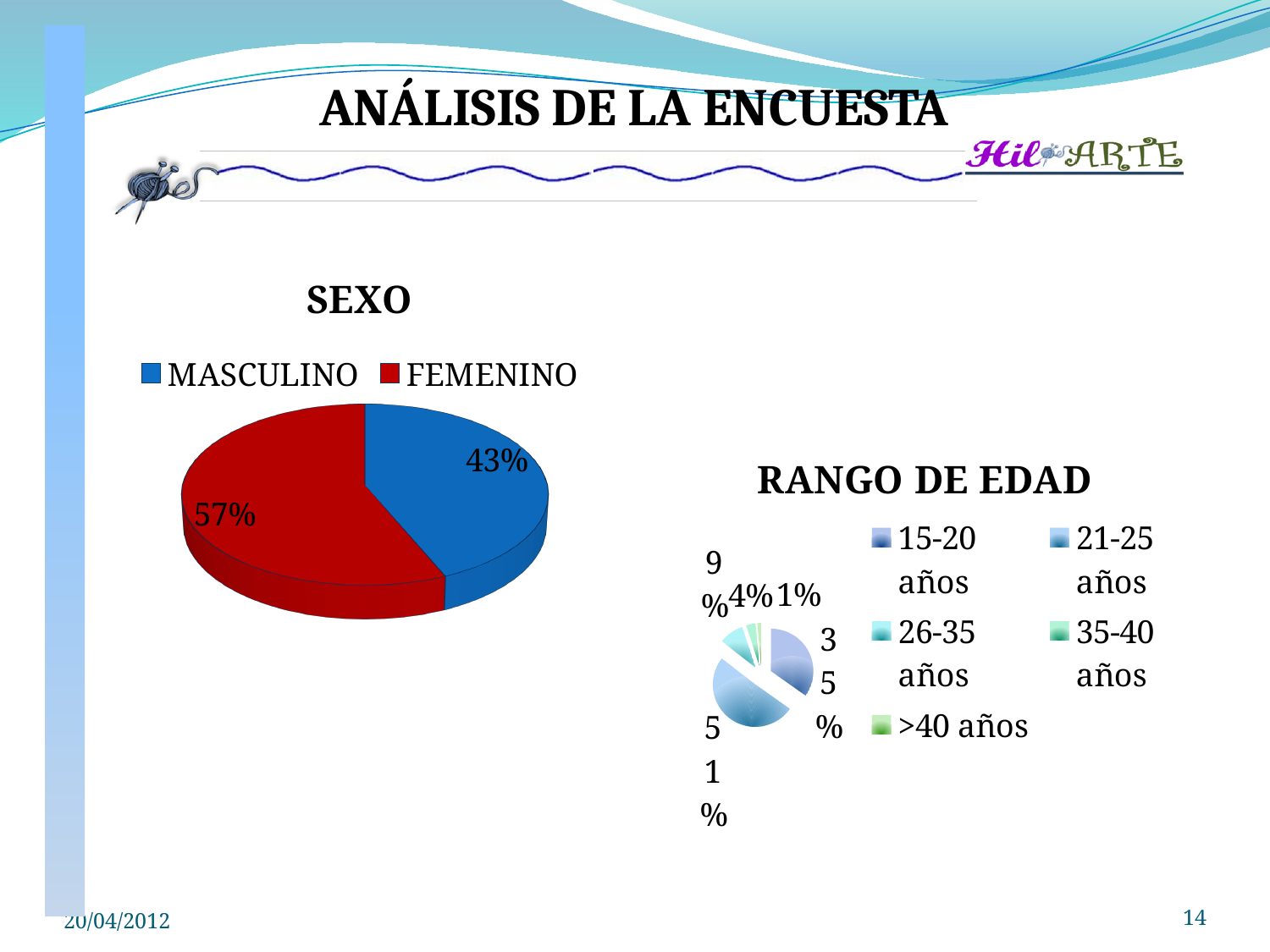
What is the title of the chart on the right side of the slide? RANGO DE EDAD In the SEXO chart, what percentage is FEMENINO? 57% How many categories does the legend of the SEXO chart list? 2 How many age ranges does the legend of the RANGO DE EDAD chart list? 5 In the SEXO chart, what percentage is MASCULINO? 43% What kind of chart is the RANGO DE EDAD chart? Pie chart In the SEXO chart, what colour is the FEMENINO slice? Red In the SEXO chart, which category has the smallest share? MASCULINO What kind of chart is the SEXO chart? Pie chart In the SEXO chart, which category has the largest share? FEMENINO In the SEXO chart, what is the difference in percentage points between FEMENINO and MASCULINO? 14 In the SEXO chart, which is larger, MASCULINO or FEMENINO? FEMENINO